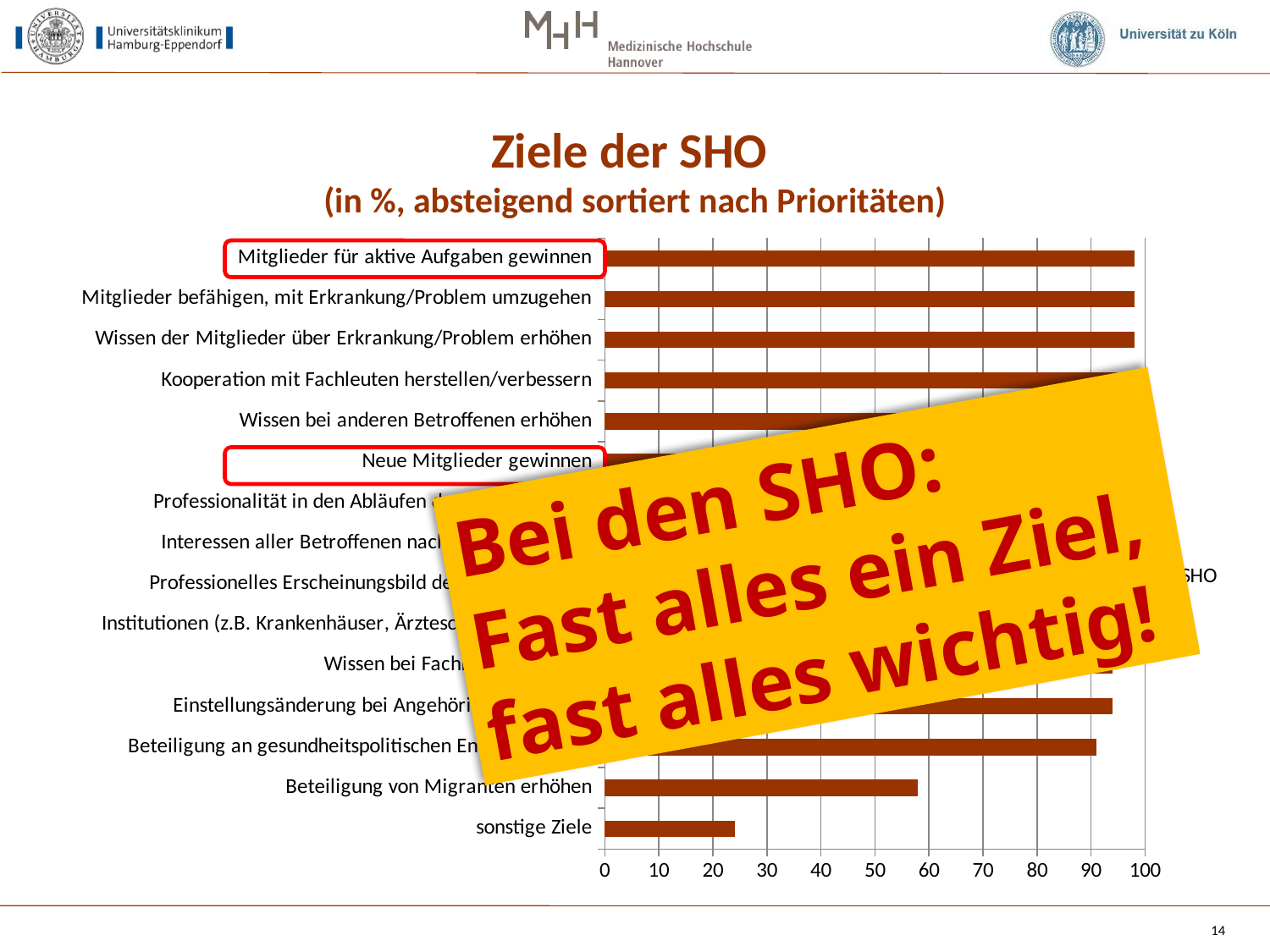
What is the highest value shown on the horizontal axis? 100 Is the value for "Mitglieder für aktive Aufgaben gewinnen" greater or less than 90? greater Is the value for "sonstige Ziele" greater or less than 30? less Which has the larger value: "Neue Mitglieder gewinnen" or "sonstige Ziele"? Neue Mitglieder gewinnen Which category has the lowest value in the chart? sonstige Ziele What kind of chart is shown on the slide? bar chart Is the value for "Beteiligung von Migranten erhöhen" greater or less than 50? greater What is the title of the chart? Ziele der SHO (in %, absteigend sortiert nach Prioritäten) How many categories (goals) are plotted in the chart? 15 Which has the larger value: "Beteiligung von Migranten erhöhen" or "sonstige Ziele"? Beteiligung von Migranten erhöhen Do the bar values increase or decrease going from the top category to the bottom category? decrease